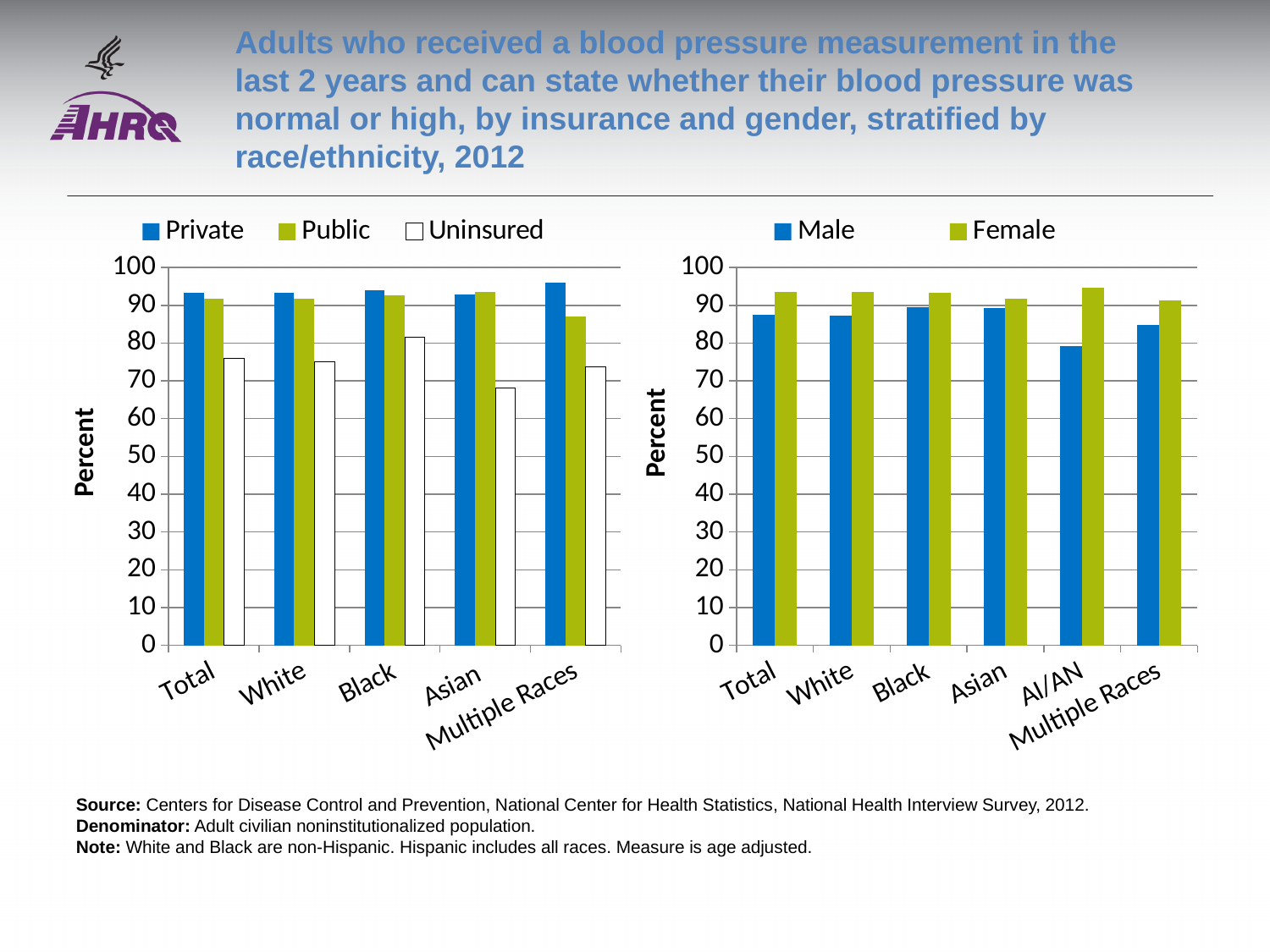
In the right chart, is the Male value for AI/AN greater or less than 70? greater What kind of chart is the left chart (Private/Public/Uninsured)? bar chart How many series does the legend of the right chart list? 2 In the right chart, for AI/AN, which is larger: the Male value or the Female value? Female In the left chart, which category has the highest Uninsured value? Black How many race/ethnicity categories are shown on the x axis of the left chart? 5 How many series does the legend of the left chart list? 3 In the right chart, which category has the lowest Male value? AI/AN In the left chart, which category has the lowest Uninsured value? Asian In the left chart, which category has the lowest Public value? Multiple Races In the left chart, is the Uninsured value for Total greater or less than 80? less How many race/ethnicity categories are shown on the x axis of the right chart? 6